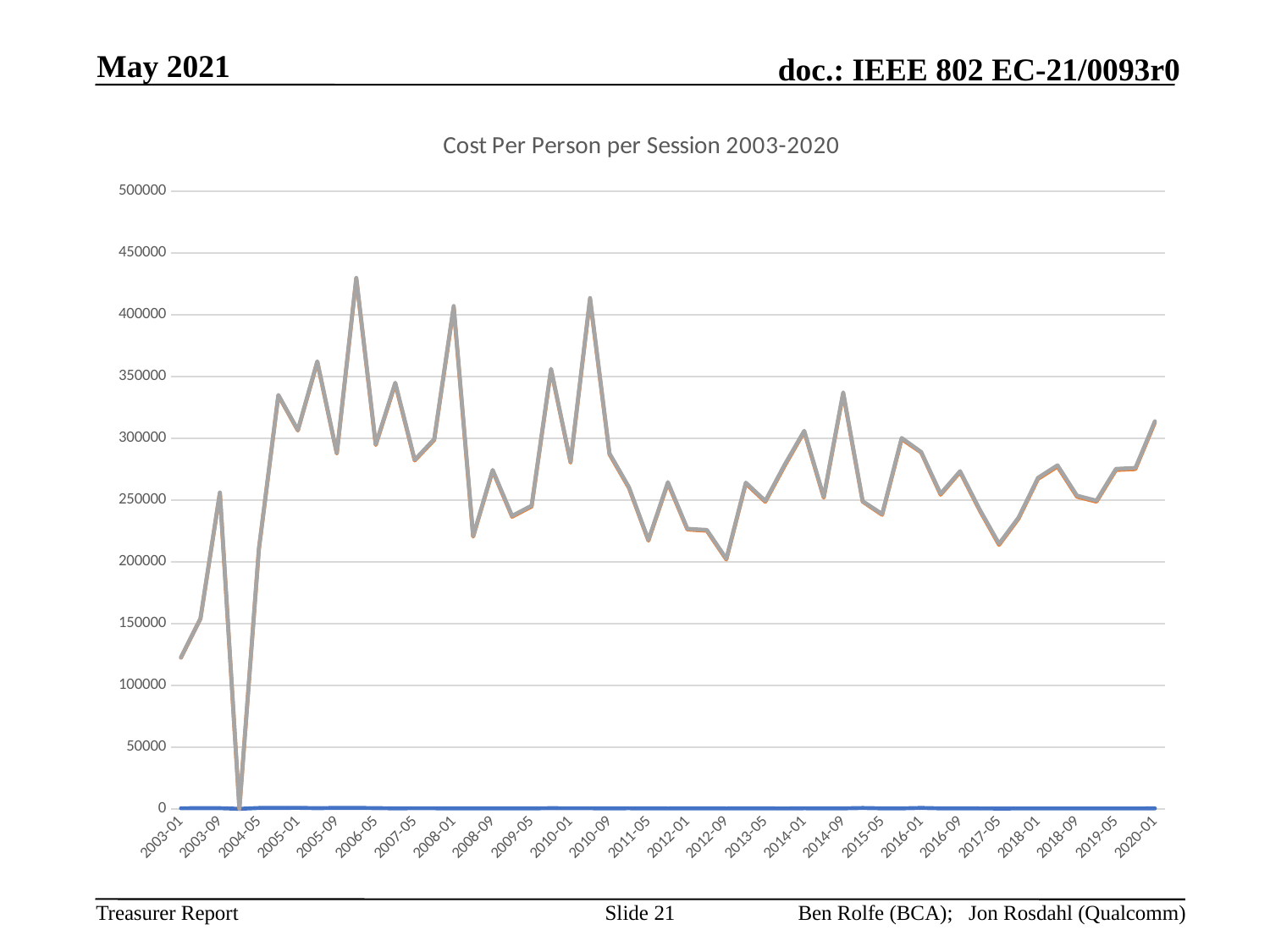
Is the value for 2020-01 greater or less than 300000? greater Which is larger, the value for 2020-01 or the value for 2017-05? 2020-01 What is the title of the chart? Cost Per Person per Session 2003-2020 What kind of chart is shown on the slide? line chart Is the value for 2005-01 greater or less than 300000? greater Which is larger, the value for 2005-01 or the value for 2003-09? 2005-01 What is the highest value shown on the vertical axis? 500000 Does the line generally rise or fall between 2017-05 and 2020-01? rise Is the value for 2003-01 greater or less than 150000? less